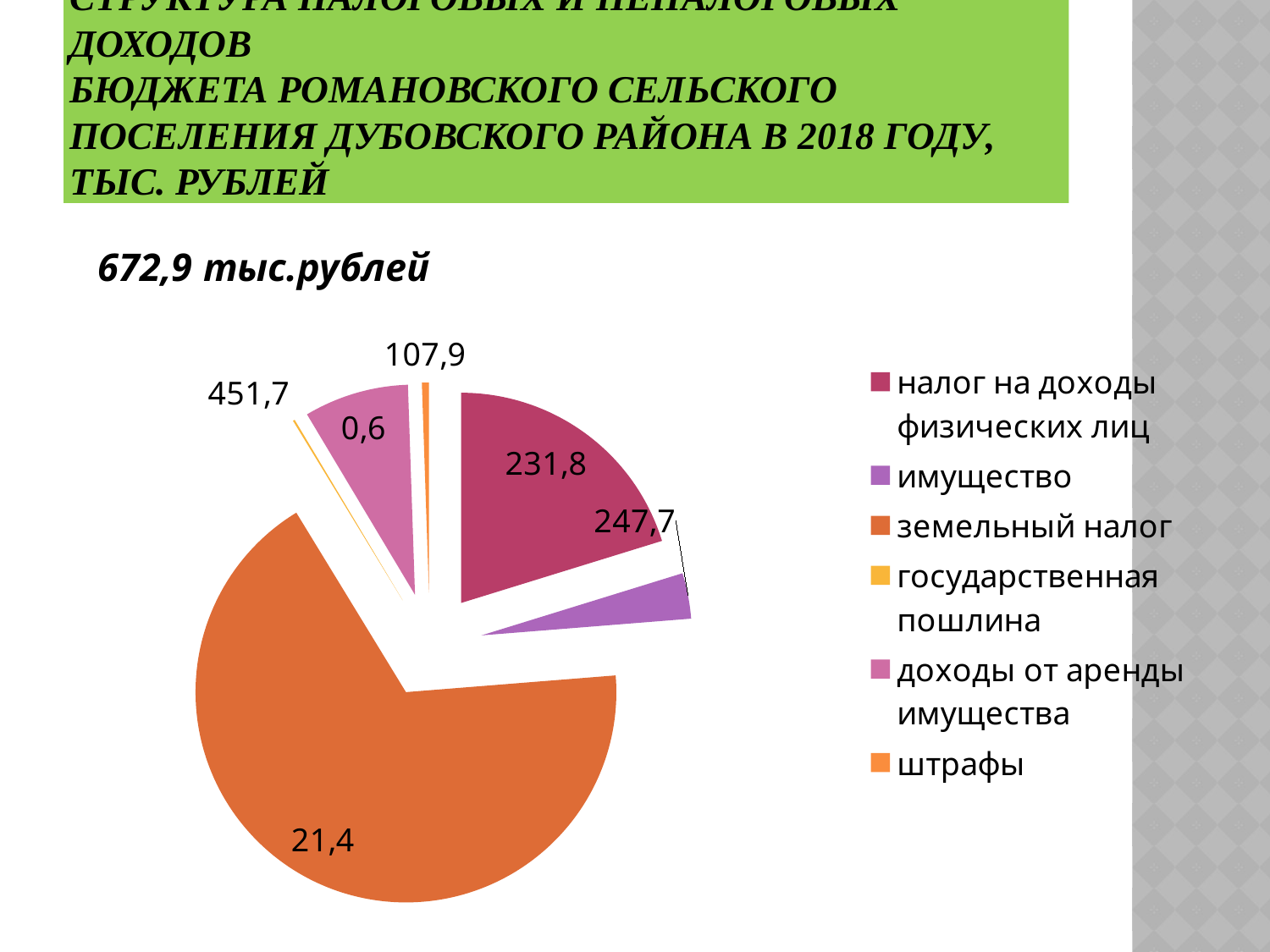
What total amount is printed above the pie chart? 672,9 тыс.рублей Which legend entry is shown in orange? земельный налог What value is labelled on the slice for государственная пошлина? 451,7 What value is labelled on the slice for штрафы? 107,9 What value is labelled on the slice for земельный налог? 21,4 What value is labelled on the slice for доходы от аренды имущества? 0,6 What value is labelled on the slice for имущество? 247,7 What value is labelled on the slice for налог на доходы физических лиц? 231,8 How many entries does the legend of the pie chart list? 6 How many slices does the pie chart have? 6 What kind of chart is shown on the slide? pie chart